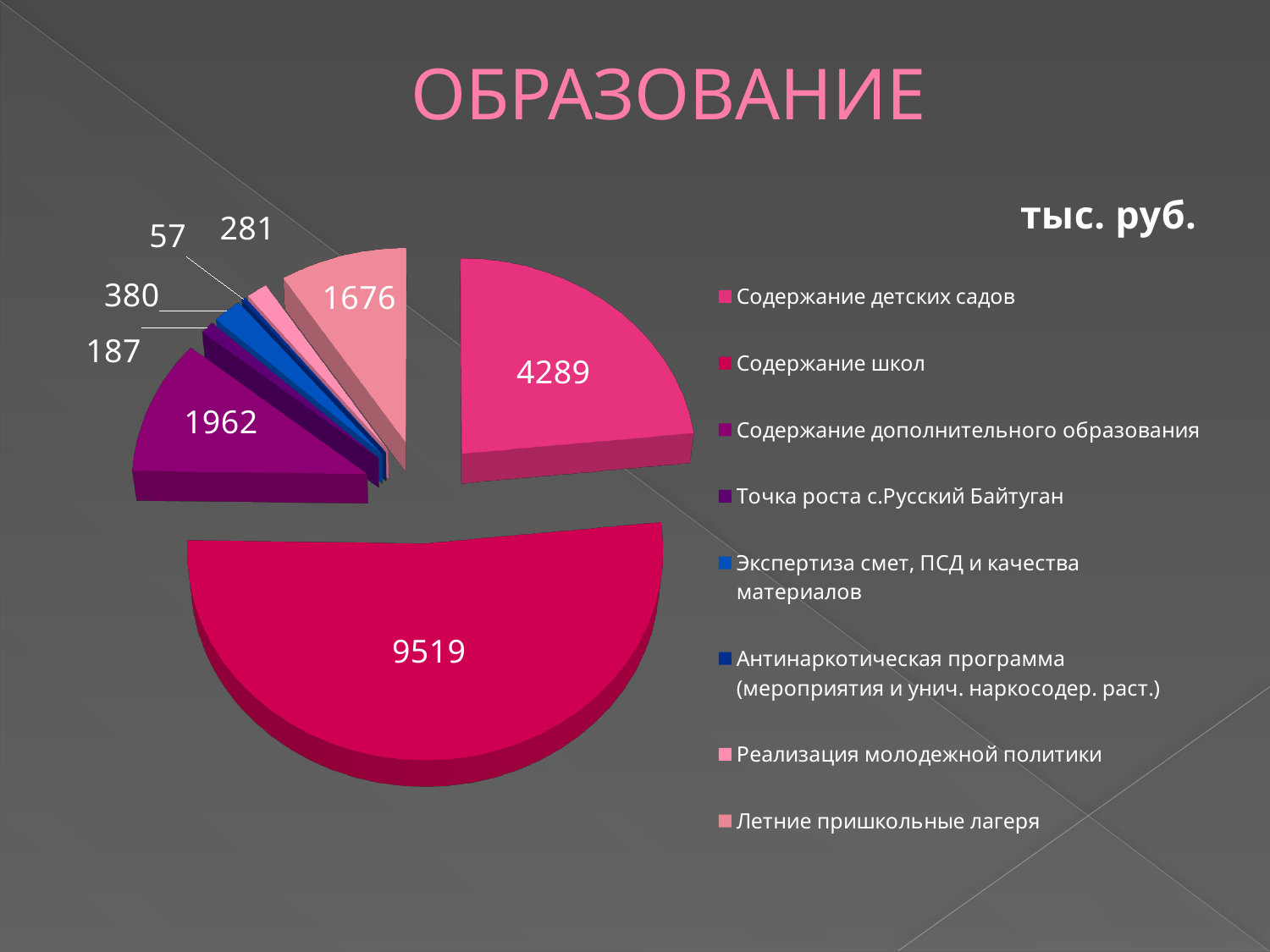
Which category has the smallest slice of the pie? Антинаркотическая программа (мероприятия и унич. наркосодер. раст.) How many entries does the legend list? 8 What is the value for Летние пришкольные лагеря? 1676 What is the value for Содержание детских садов? 4289 What is the value for Экспертиза смет, ПСД и качества материалов? 380 Which category has the largest slice of the pie? Содержание школ Which is larger, the value for Содержание дополнительного образования or the value for Летние пришкольные лагеря? Содержание дополнительного образования What is the value for Содержание школ? 9519 What unit is stated for the values in the chart? тыс. руб. What kind of chart is shown on the slide? Pie chart What is the difference between the values for Содержание школ and Содержание детских садов? 5230 How many slices does the pie chart have? 8